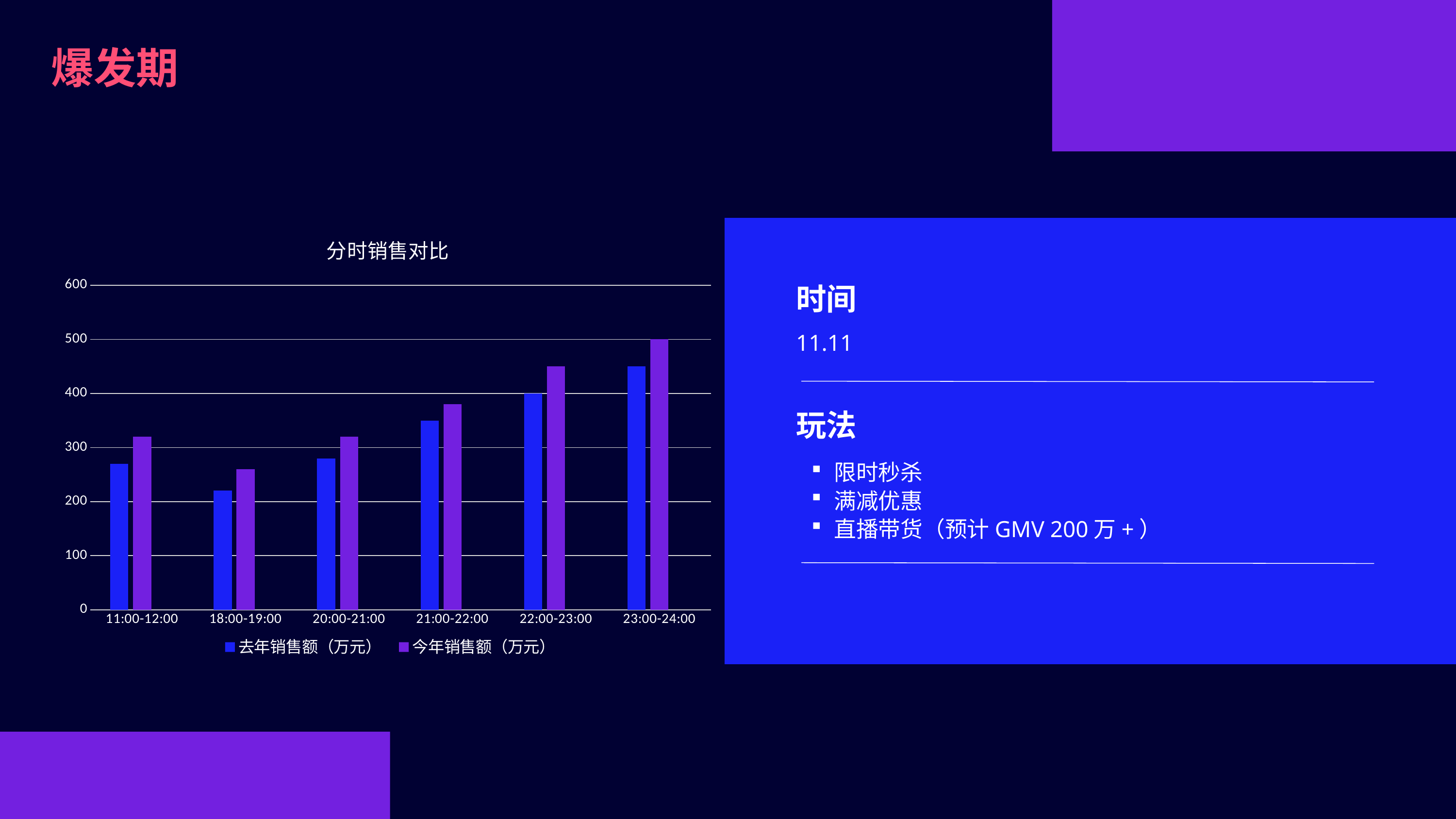
Is the value for 今年销售额（万元） at 21:00-22:00 greater or less than 300? greater From 18:00-19:00 to 23:00-24:00, do the values for 今年销售额（万元） rise or fall? rise Is the value for 今年销售额（万元） at 18:00-19:00 greater or less than 300? less How many series does the chart legend list? 2 Which time slot has the lowest value for 去年销售额（万元）? 18:00-19:00 How many time-slot categories are shown on the x axis? 6 Which legend entry is shown in purple? 今年销售额（万元） What kind of chart is shown on the slide? bar chart Is the value for 去年销售额（万元） at 11:00-12:00 greater or less than 300? less At 22:00-23:00, which series has the larger value, 去年销售额（万元） or 今年销售额（万元）? 今年销售额（万元） Which time slot has the highest value for 今年销售额（万元）? 23:00-24:00 What is the title of the chart? 分时销售对比